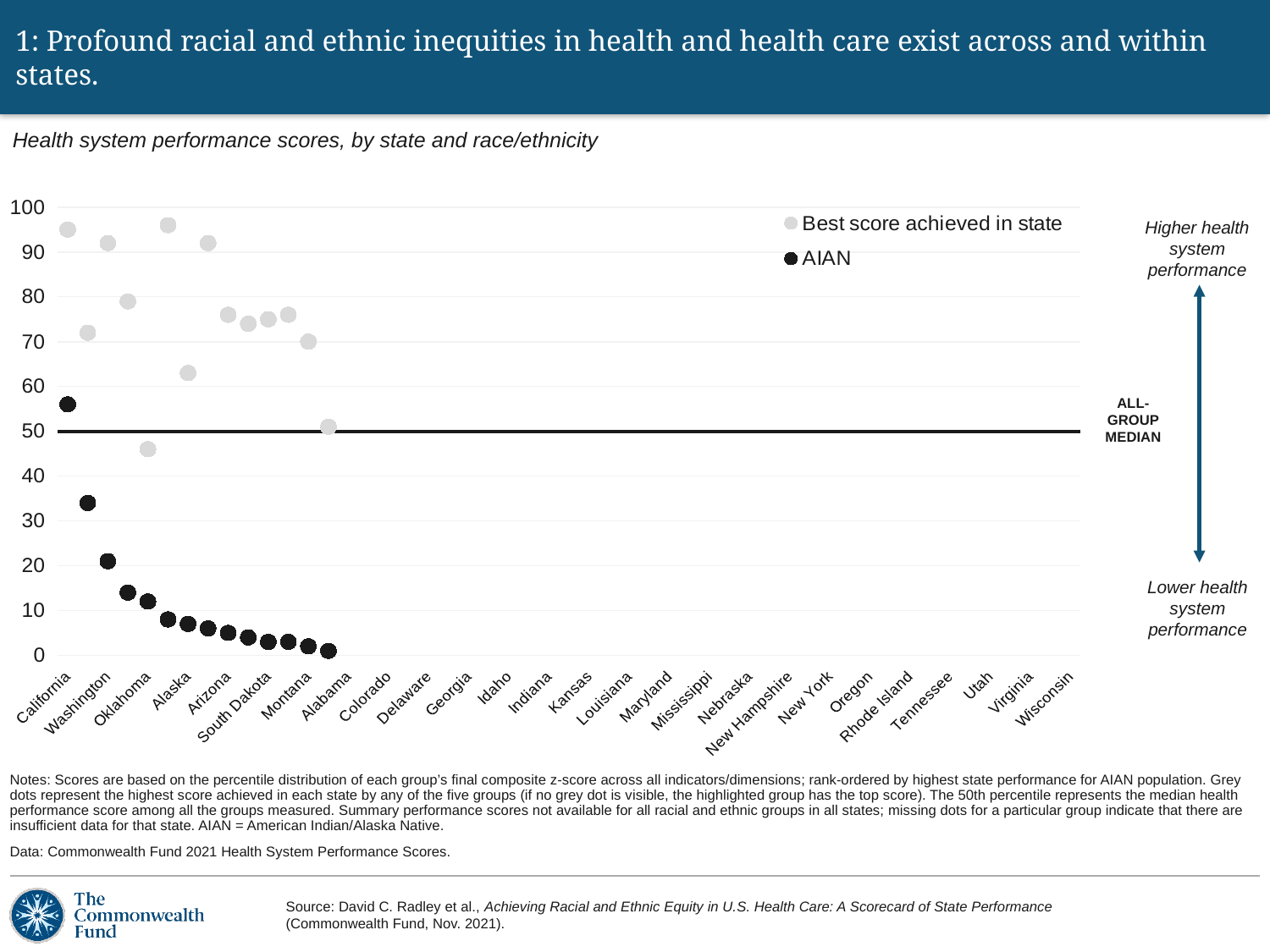
For California, which is larger: the AIAN score or the best score achieved in the state? Best score achieved in state How many AIAN dots lie above the all-group median line? 1 At what value is the horizontal all-group median line drawn? 50 Is the AIAN value for California greater or less than 60? less Do the AIAN scores rise or fall moving from left to right along the x axis? fall Which state has the highest AIAN score? California Is the best score achieved in California greater or less than 90? greater Which state is listed first on the x axis? California Is the AIAN value for California greater or less than 50? greater What are the two series named in the legend? Best score achieved in state; AIAN What kind of chart is shown on the slide? Scatter (dot) chart How many series does the legend list? 2